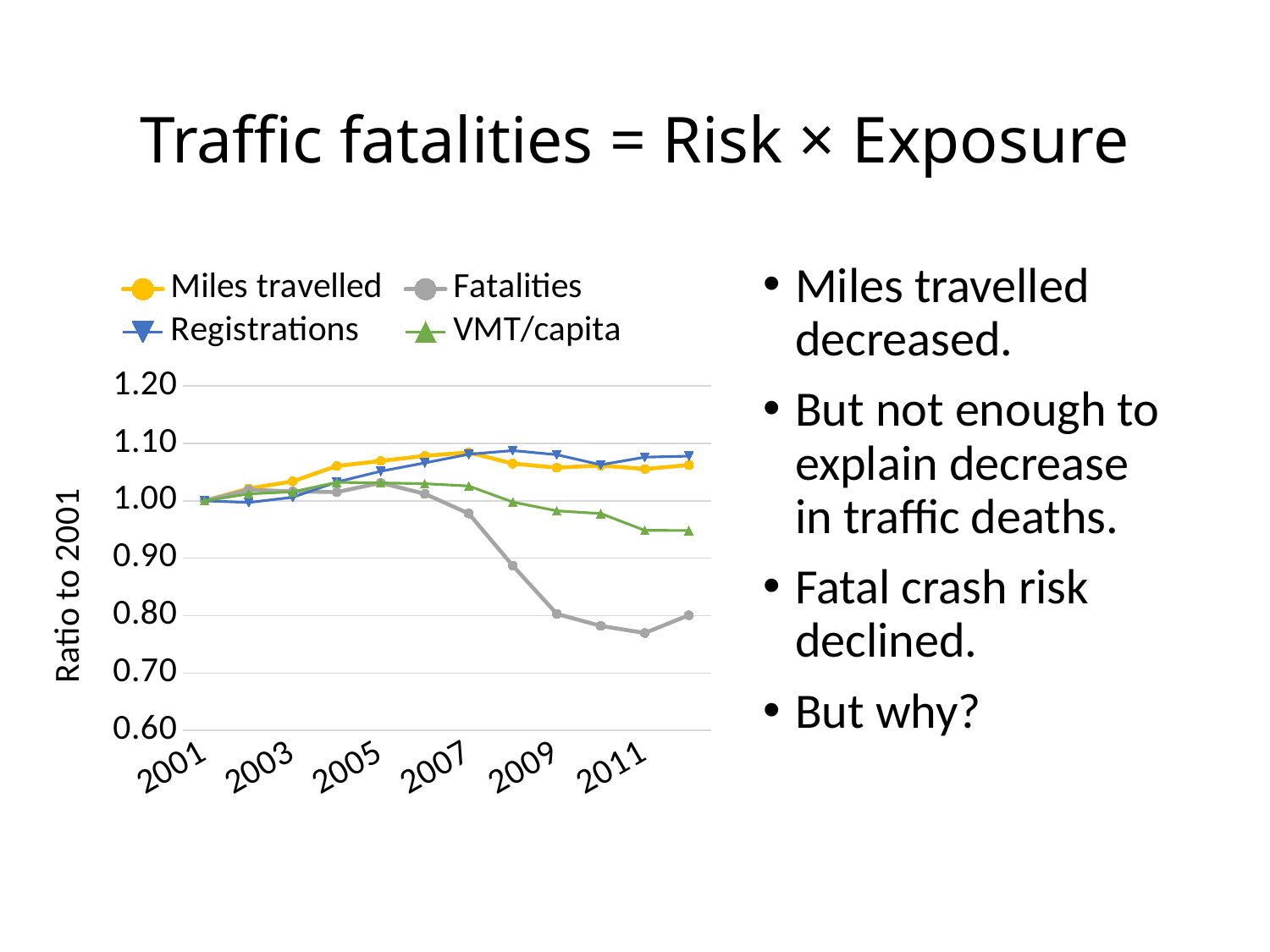
What is the label on the vertical axis of the chart? Ratio to 2001 Which series in the chart is drawn in grey with circle markers? Fatalities Does the VMT/capita series rise or fall between 2007 and 2011? Fall What kind of chart is shown on the slide? Line chart Is the value for Miles travelled in 2007 greater or less than 1.00? greater Which series has the lowest value in 2011? Fatalities How many series does the chart legend list? 4 Is the value for VMT/capita in 2011 greater or less than 1.00? less Does the Fatalities series rise or fall between 2007 and 2011? Fall Is the value for Registrations in 2009 greater or less than 1.00? greater In 2011, which is larger: Miles travelled or Fatalities? Miles travelled